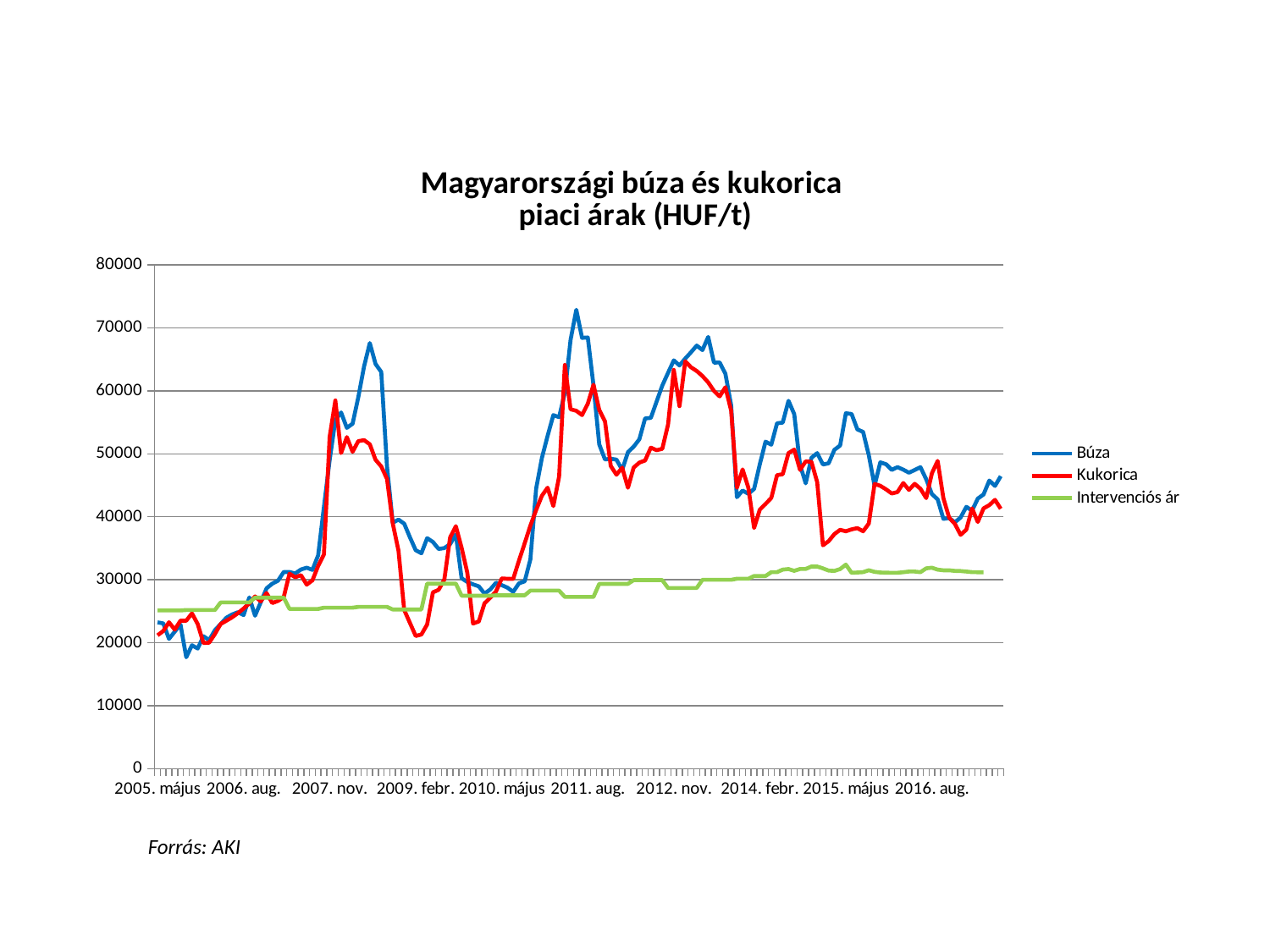
What kind of chart is shown on the slide? line chart How many date labels are printed along the x axis? 10 How many series does the legend list? 3 Around 2011. aug., which series is higher, Búza or Kukorica? Búza Is the Intervenciós ár series ever greater or less than 40000 across the whole chart? less Which series reaches the highest value anywhere on the chart? Búza Is the peak value of the Búza series greater or less than 70000? greater Is the Kukorica value around 2009. febr. greater or less than 30000? less What is the title of the chart? Magyarországi búza és kukorica piaci árak (HUF/t) Does the Intervenciós ár series generally rise or fall from 2005. május to 2016. aug.? rise What are the three series named in the legend? Búza, Kukorica, Intervenciós ár Which series stays the lowest for most of the period shown? Intervenciós ár